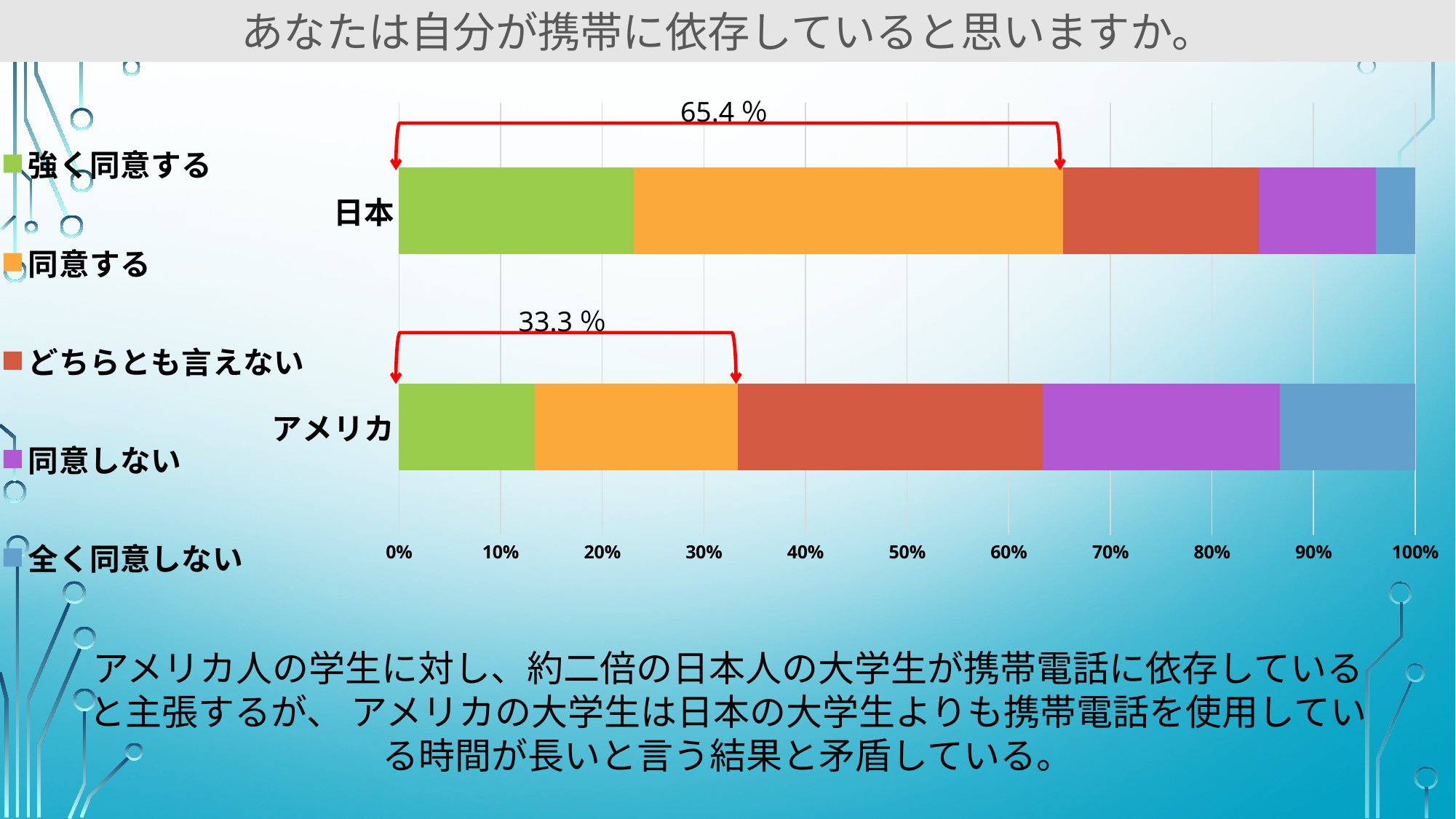
Which country has the larger 同意する segment? 日本 What combined percentage is annotated above the 日本 bar for 強く同意する and 同意する? 65.4 % Is the 強く同意する segment for 日本 greater or less than 20%? greater What combined percentage is annotated above the アメリカ bar for 強く同意する and 同意する? 33.3 % What colour represents 同意しない in the legend? Purple What is the difference between the annotated agreement share for 日本 (65.4 %) and for アメリカ (33.3 %)? 32.1 % What kind of chart is shown on the slide? Stacked bar chart Is the 強く同意する segment for アメリカ greater or less than 20%? less Which country has the larger どちらとも言えない segment? アメリカ How many series does the legend list? 5 Which country has the larger annotated agreement share (強く同意する + 同意する)? 日本 How many countries (categories) are plotted in the chart? 2